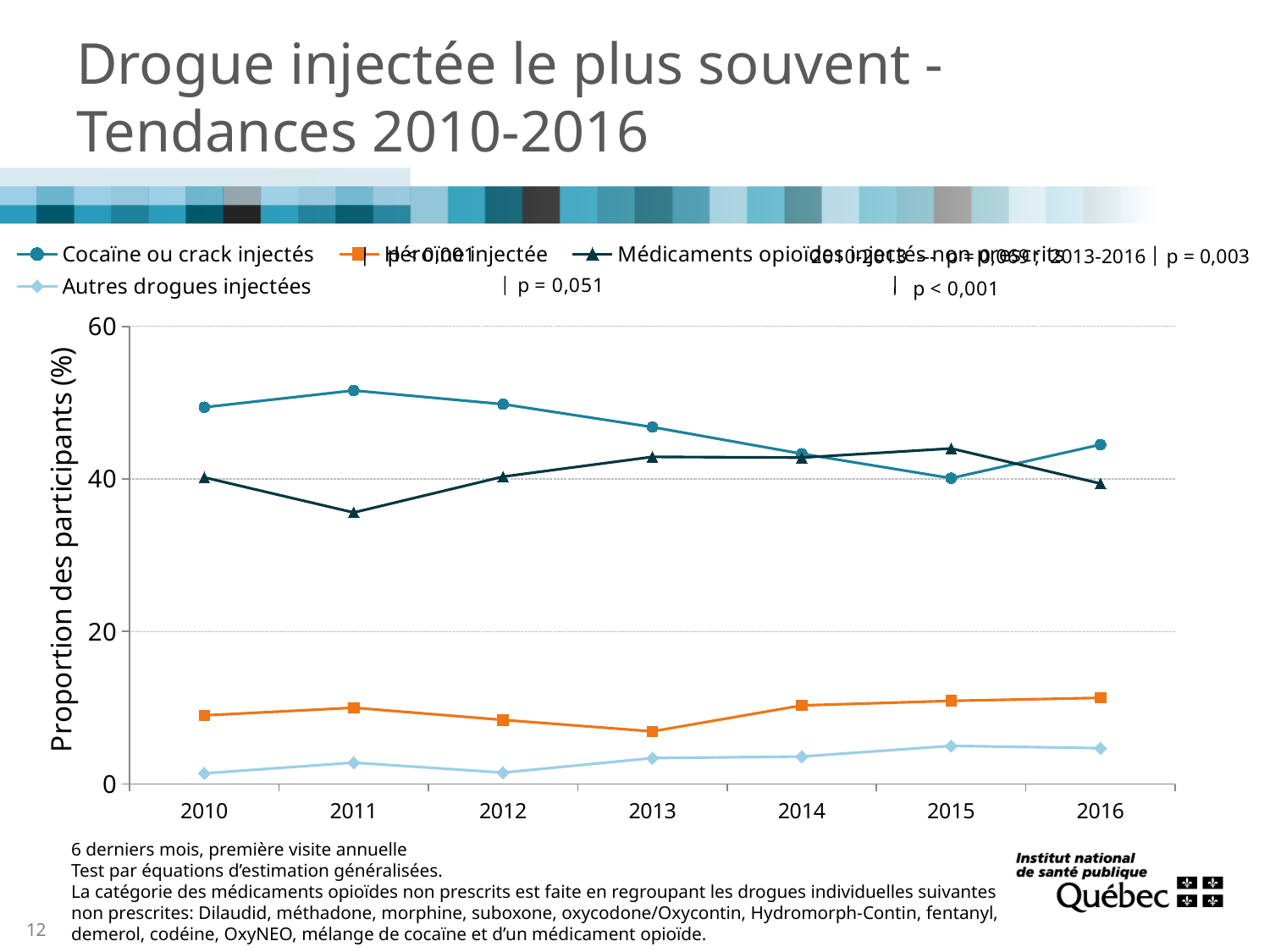
What is the title of the y axis? Proportion des participants (%) In which year is the value for Cocaïne ou crack injectés lowest? 2015 How many years are plotted along the x axis? 7 Is the value for Héroïne injectée in 2016 greater or less than 20? less In which year is the value for Héroïne injectée lowest? 2013 Is the value for Cocaïne ou crack injectés in 2010 greater or less than 40? greater Is the value for Médicaments opioïdes injectés non prescrits in 2011 greater or less than 40? less How many series does the legend list? 4 In which year is the value for Médicaments opioïdes injectés non prescrits lowest? 2011 Does the value for Cocaïne ou crack injectés rise or fall from 2011 to 2015? fall In 2016, which is larger: Cocaïne ou crack injectés or Médicaments opioïdes injectés non prescrits? Cocaïne ou crack injectés What kind of chart is shown on the slide? line chart